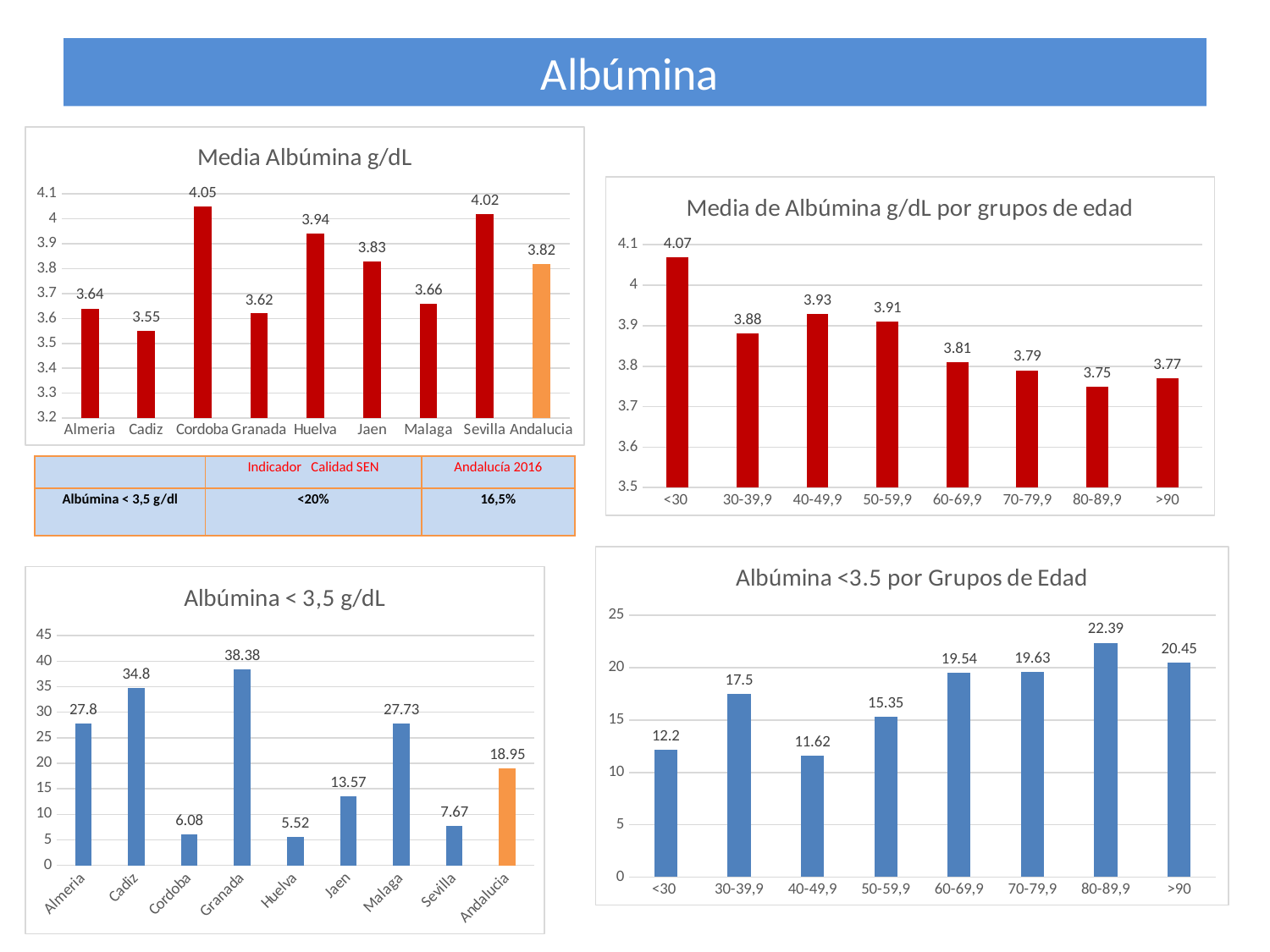
In the 'Albúmina < 3,5 g/dL' chart, which category has the lowest value? Huelva In the 'Media Albúmina g/dL' chart, what is the difference between Cordoba and Cadiz? 0.5 In the 'Media de Albúmina g/dL por grupos de edad' chart, what is the value for the 80-89,9 group? 3.75 What kind of chart is the 'Albúmina <3.5 por Grupos de Edad' chart? Bar chart In the 'Media Albúmina g/dL' chart, what is the value for Cordoba? 4.05 In the 'Media Albúmina g/dL' chart, which province has the lowest value? Cadiz In the 'Media de Albúmina g/dL por grupos de edad' chart, which age group has the highest value? <30 In the 'Albúmina < 3,5 g/dL' chart, what is the value for Granada? 38.38 In the 'Media de Albúmina g/dL por grupos de edad' chart, how many age groups are shown? 8 In the 'Albúmina <3.5 por Grupos de Edad' chart, what is the value for the 60-69,9 group? 19.54 In the 'Albúmina <3.5 por Grupos de Edad' chart, which age group has the highest value? 80-89,9 In the 'Albúmina < 3,5 g/dL' chart, which is larger, Cadiz or Malaga? Cadiz